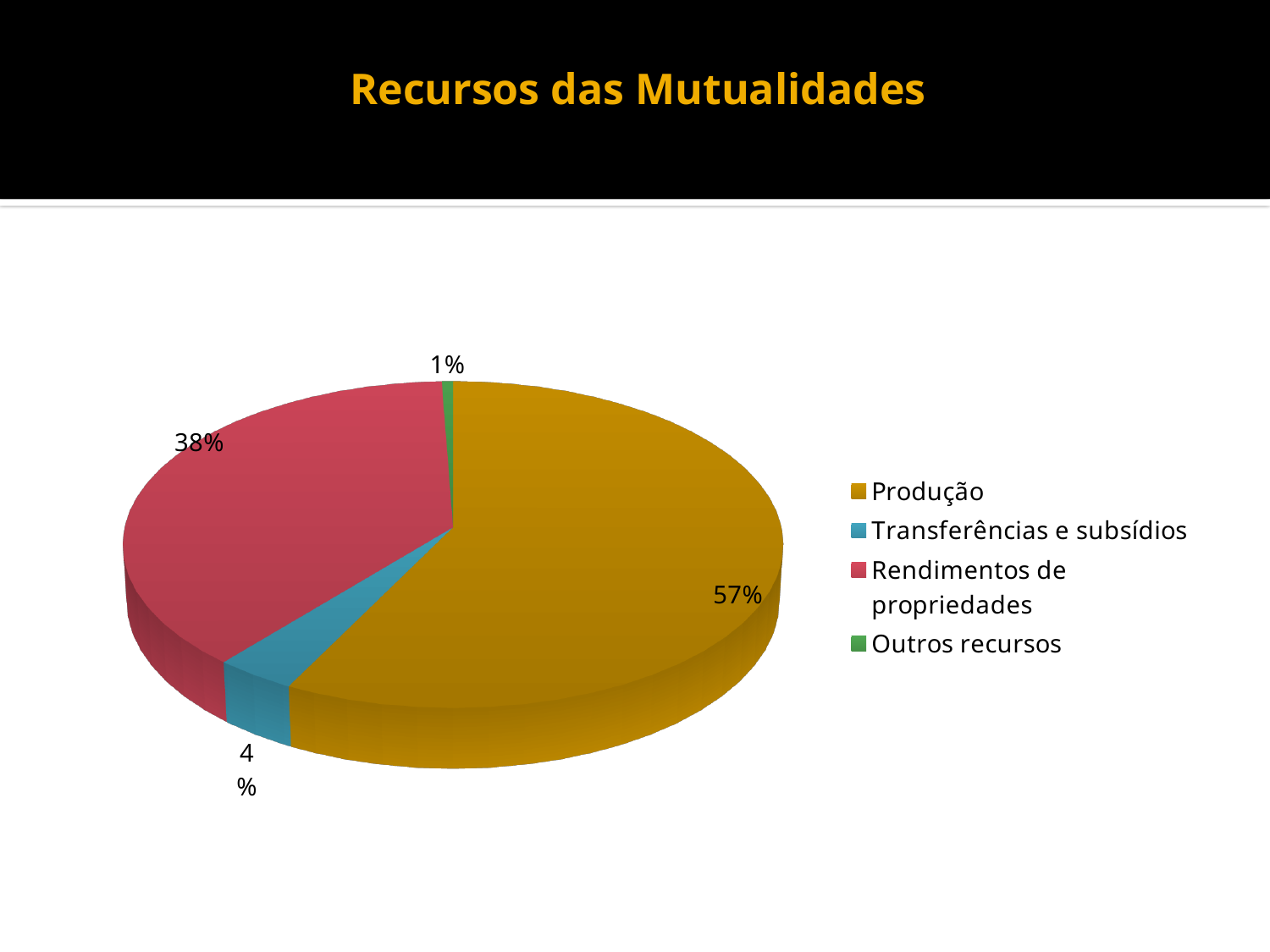
How many categories are shown in the pie chart? 4 What share of the pie does Rendimentos de propriedades represent? 38% Which is larger, Transferências e subsídios or Rendimentos de propriedades? Rendimentos de propriedades What share of the pie does Outros recursos represent? 1% What is the title of the slide containing the chart? Recursos das Mutualidades Which category has the largest slice of the pie? Produção Which category has the smallest slice of the pie? Outros recursos What share of the pie does Transferências e subsídios represent? 4% What kind of chart is shown on the slide? Pie chart What colour is the slice for Produção? Gold/yellow What is the difference in percentage points between Produção and Rendimentos de propriedades? 19